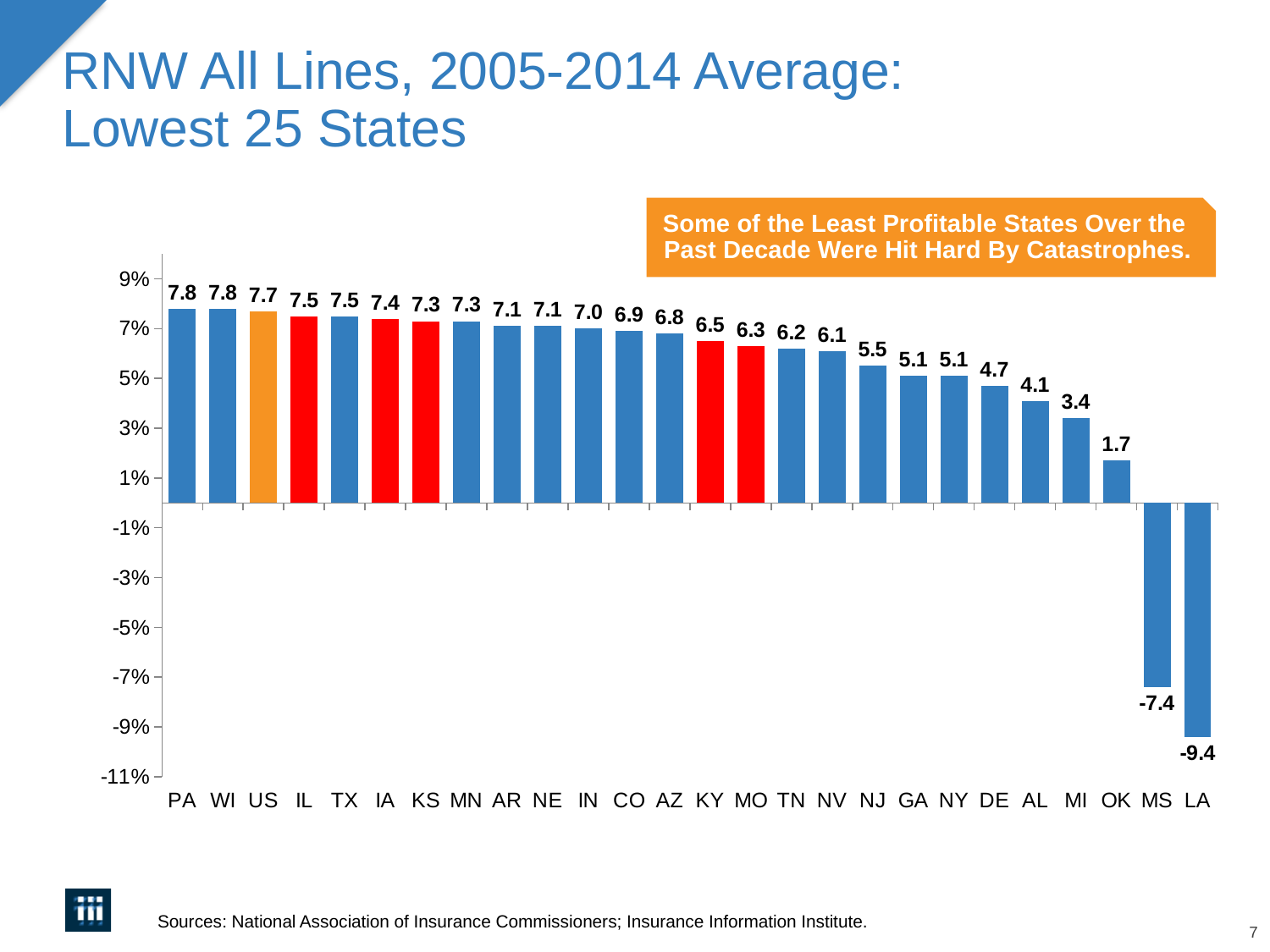
What is the difference between the values for PA and OK? 6.1 What is the value for OK? 1.7 What is the difference between the values for MS and LA? 2.0 What is the value for LA? -9.4 Which category has the lowest value? LA Do the values generally rise or fall from left to right along the x axis? fall Which is larger, the value for NJ or the value for DE? NJ How many bars are plotted on the chart? 26 What is the value for KY? 6.5 What kind of chart is shown on the slide? bar chart Is the value for MI greater or less than 5%? less What is the value for the US bar? 7.7